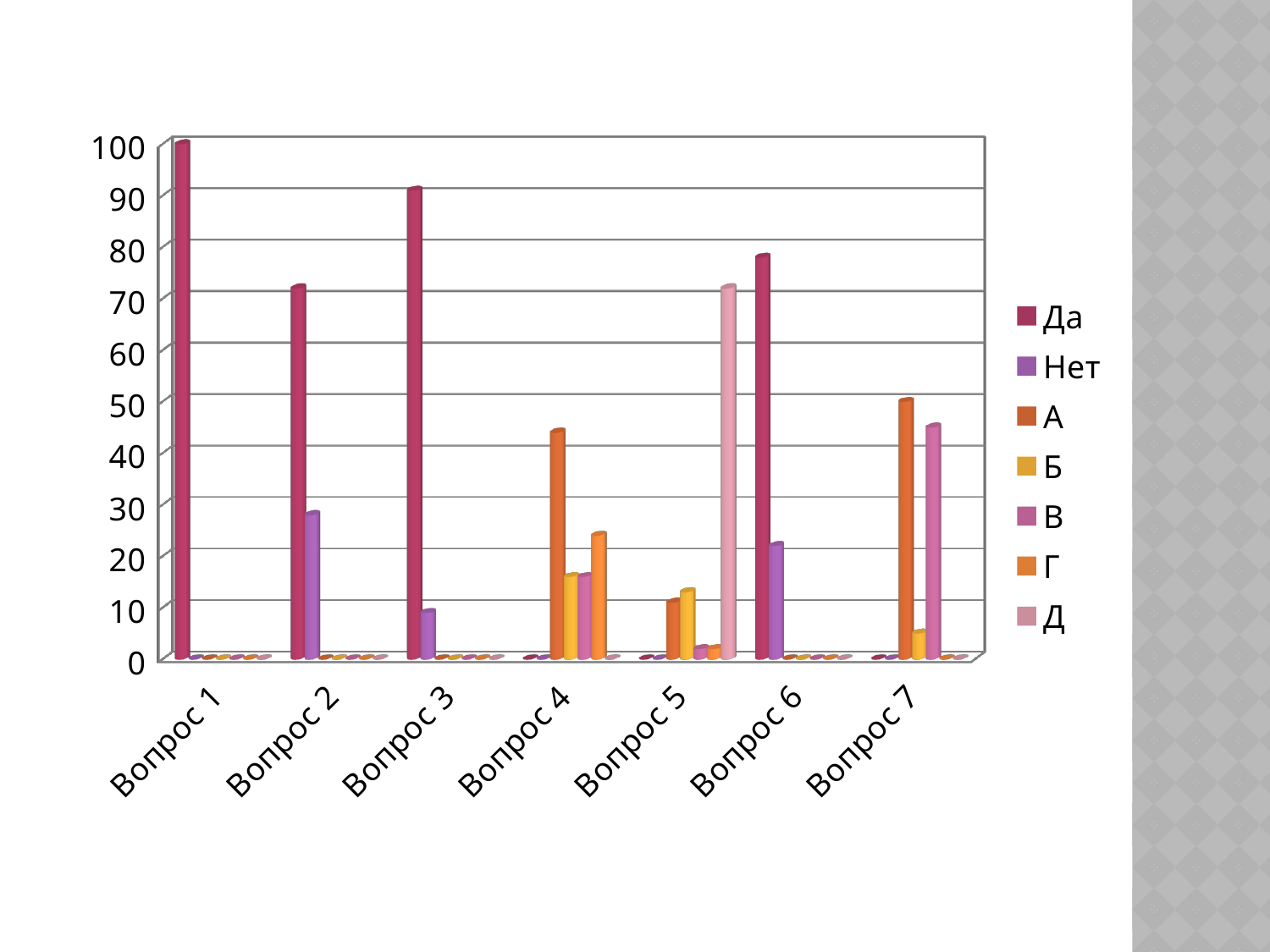
Is the Д value for Вопрос 5 greater or less than 60? greater How many categories (questions) are shown on the x axis? 7 For Вопрос 7, which is larger: the А value or the Б value? А Is the Да value for Вопрос 2 greater or less than 50? greater What is the first entry listed in the legend? Да Is the Нет value for Вопрос 2 greater or less than 40? less Which question has the highest value for the Да series? Вопрос 1 For Вопрос 6, which is larger: the Да value or the Нет value? Да How many series does the legend list? 7 What kind of chart is shown on the slide? Bar chart